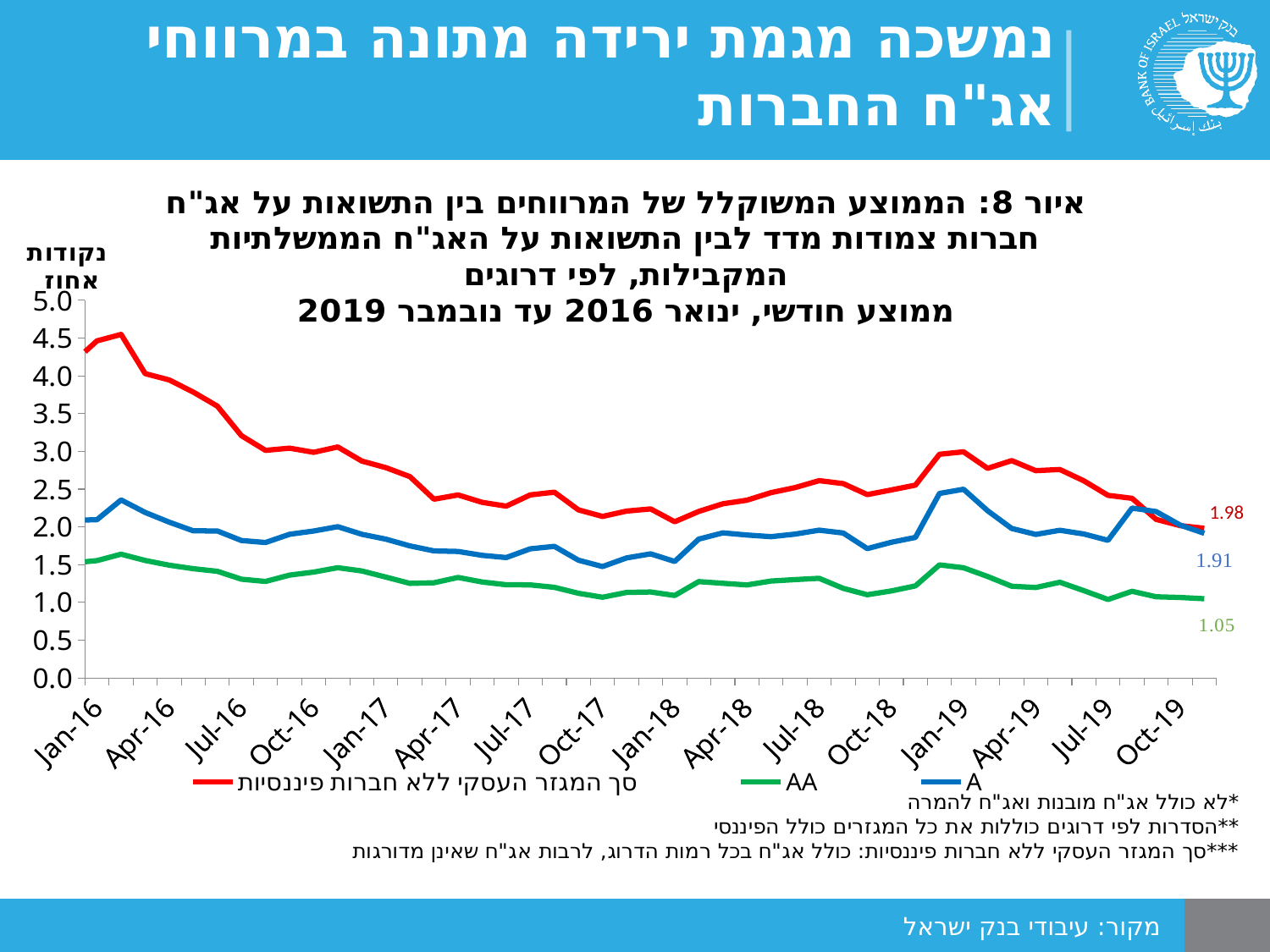
What is the final labelled value of the 'A' series? 1.91 What is the difference between the final labelled values of 'סך המגזר העסקי ללא חברות פיננסיות' (1.98) and 'AA' (1.05)? 0.93 At the end of the period, which series has the larger value, 'A' or 'AA'? A What is the difference between the final labelled values of 'סך המגזר העסקי ללא חברות פיננסיות' (1.98) and 'A' (1.91)? 0.07 What is the final labelled value of the series 'סך המגזר העסקי ללא חברות פיננסיות'? 1.98 Which series has the highest value at Jan-16? סך המגזר העסקי ללא חברות פיננסיות How many series does the legend list? 3 What unit label is shown on the y axis of the chart? נקודות אחוז Does the 'סך המגזר העסקי ללא חברות פיננסיות' series generally rise or fall from Jan-16 to the end of the period? fall What is the final labelled value of the 'AA' series? 1.05 Is the value of 'סך המגזר העסקי ללא חברות פיננסיות' at Jan-16 greater or less than 4.0? greater What kind of chart is shown on the slide? line chart